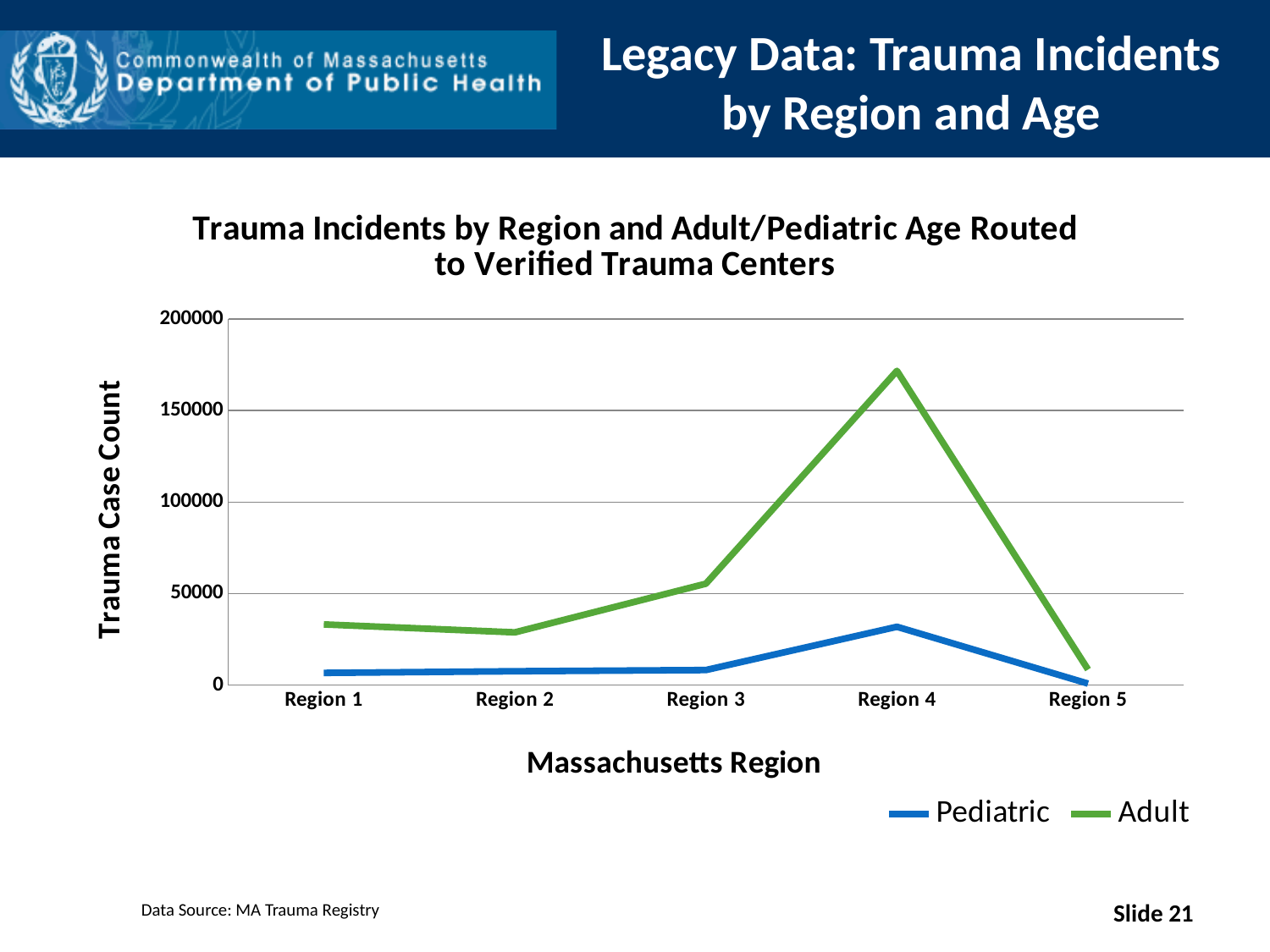
Is the Adult value for Region 3 greater or less than 100000? less Which region has the lowest Adult trauma case count? Region 5 What is the label of the y axis? Trauma Case Count Which region has the highest Adult trauma case count? Region 4 Is the Adult value for Region 4 greater or less than 150000? greater Which is larger in Region 1, the Adult value or the Pediatric value? Adult Is the Pediatric value for Region 4 greater or less than 50000? less How many regions are shown on the x axis? 5 Which region has the highest Pediatric trauma case count? Region 4 Which region has the lowest Pediatric trauma case count? Region 5 What kind of chart is shown on the slide? line chart How many series does the legend list? 2